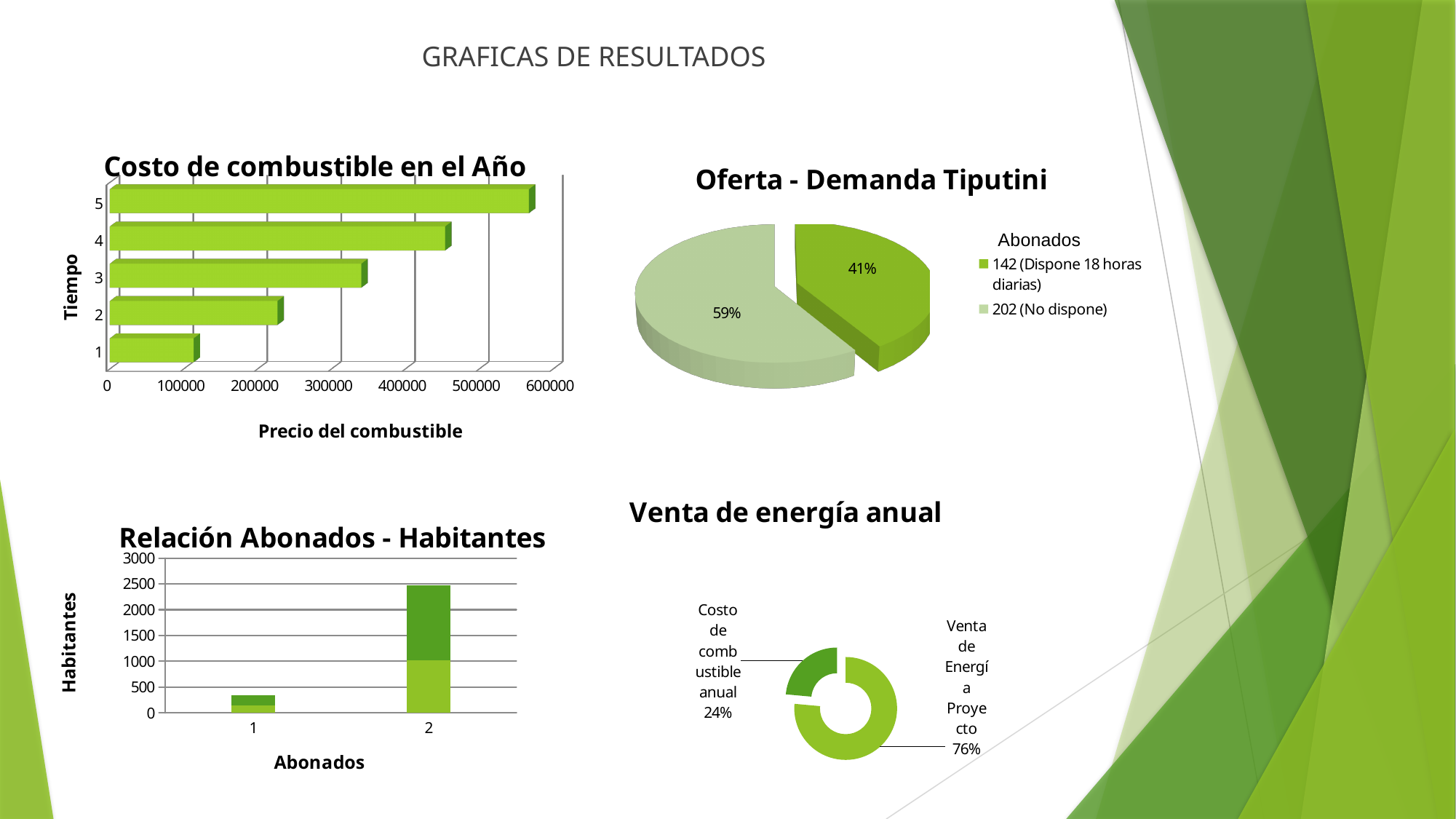
In the 'Costo de combustible en el Año' chart, how many time categories are plotted? 5 In the 'Relación Abonados - Habitantes' chart, is the total for category 2 greater or less than 2000? greater In the 'Costo de combustible en el Año' chart, which time category has the lowest fuel cost? 1 In the 'Venta de energía anual' chart, what is the difference between the 'Venta de Energía Proyecto' share and the 'Costo de combustible anual' share? 52% In the 'Costo de combustible en el Año' chart, is the value for time 2 greater or less than 300000? less In the 'Costo de combustible en el Año' chart, is the value for time 5 greater or less than 500000? greater In the 'Costo de combustible en el Año' chart, what kind of chart is shown? bar chart In the 'Oferta - Demanda Tiputini' pie chart, what share corresponds to '202 (No dispone)'? 59% In the 'Costo de combustible en el Año' chart, do the fuel costs rise or fall as time goes from 1 to 5? rise In the 'Oferta - Demanda Tiputini' pie chart, what share corresponds to '142 (Dispone 18 horas diarias)'? 41% In the 'Costo de combustible en el Año' chart, which time category has the highest fuel cost? 5 In the 'Venta de energía anual' chart, what percentage is 'Costo de combustible anual'? 24%